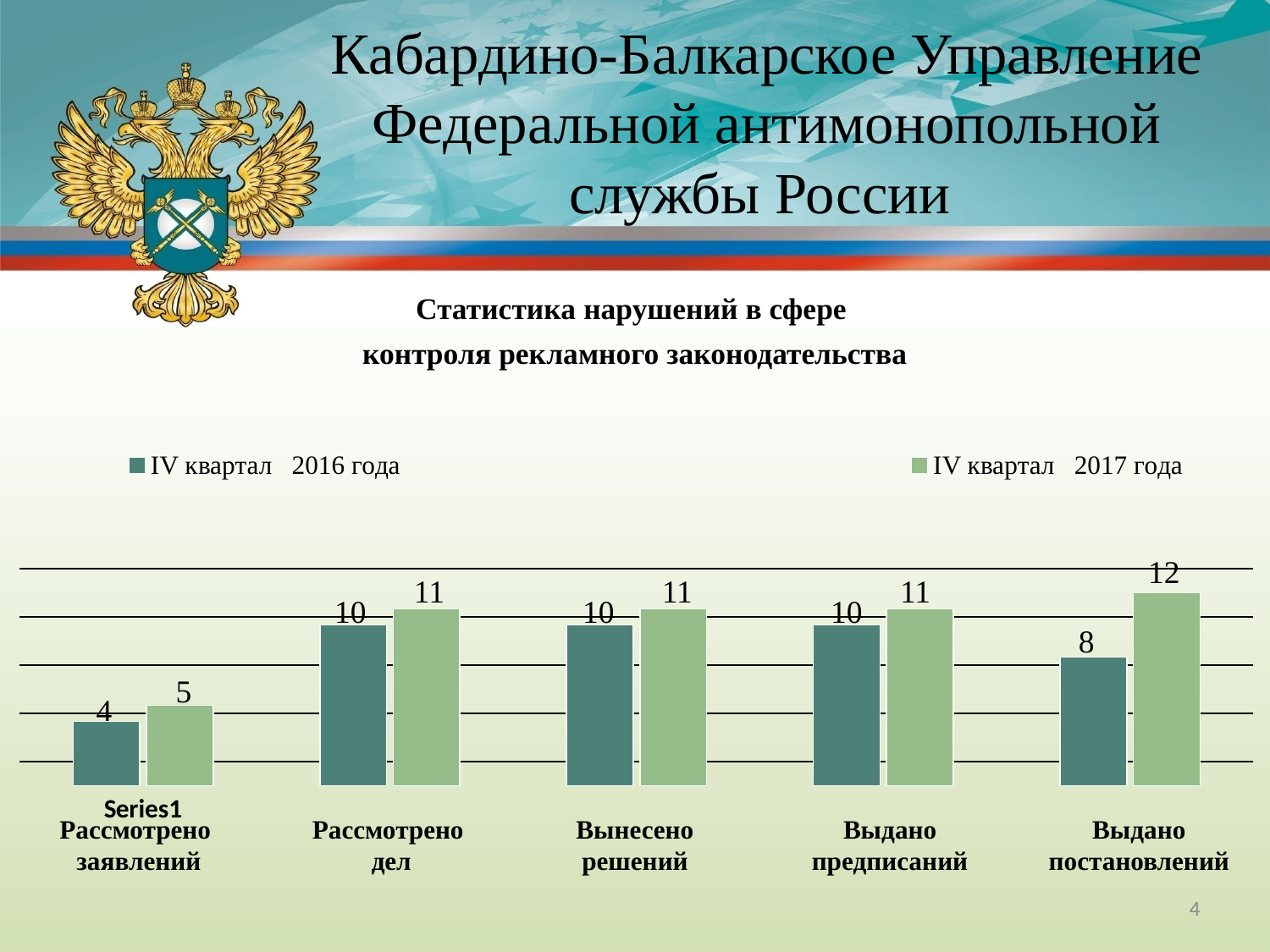
What is the difference between the "IV квартал 2017 года" and "IV квартал 2016 года" values for "Рассмотрено заявлений"? 1 What is the title of the chart on the slide? Статистика нарушений в сфере контроля рекламного законодательства Which category has the lowest value in the "IV квартал 2016 года" series? Рассмотрено заявлений What is the value for "Рассмотрено заявлений" in the "IV квартал 2016 года" series? 4 How many series does the chart legend list? 2 What kind of chart is shown on the slide? Bar chart For "Выдано предписаний", which series has the larger value: "IV квартал 2016 года" or "IV квартал 2017 года"? IV квартал 2017 года Which category has the highest value in the "IV квартал 2017 года" series? Выдано постановлений What is the value for "Выдано постановлений" in the "IV квартал 2017 года" series? 12 How many categories are shown on the x axis of the chart? 5 What is the value for "Рассмотрено дел" in the "IV квартал 2017 года" series? 11 What is the difference between the "IV квартал 2017 года" and "IV квартал 2016 года" values for "Выдано постановлений"? 4